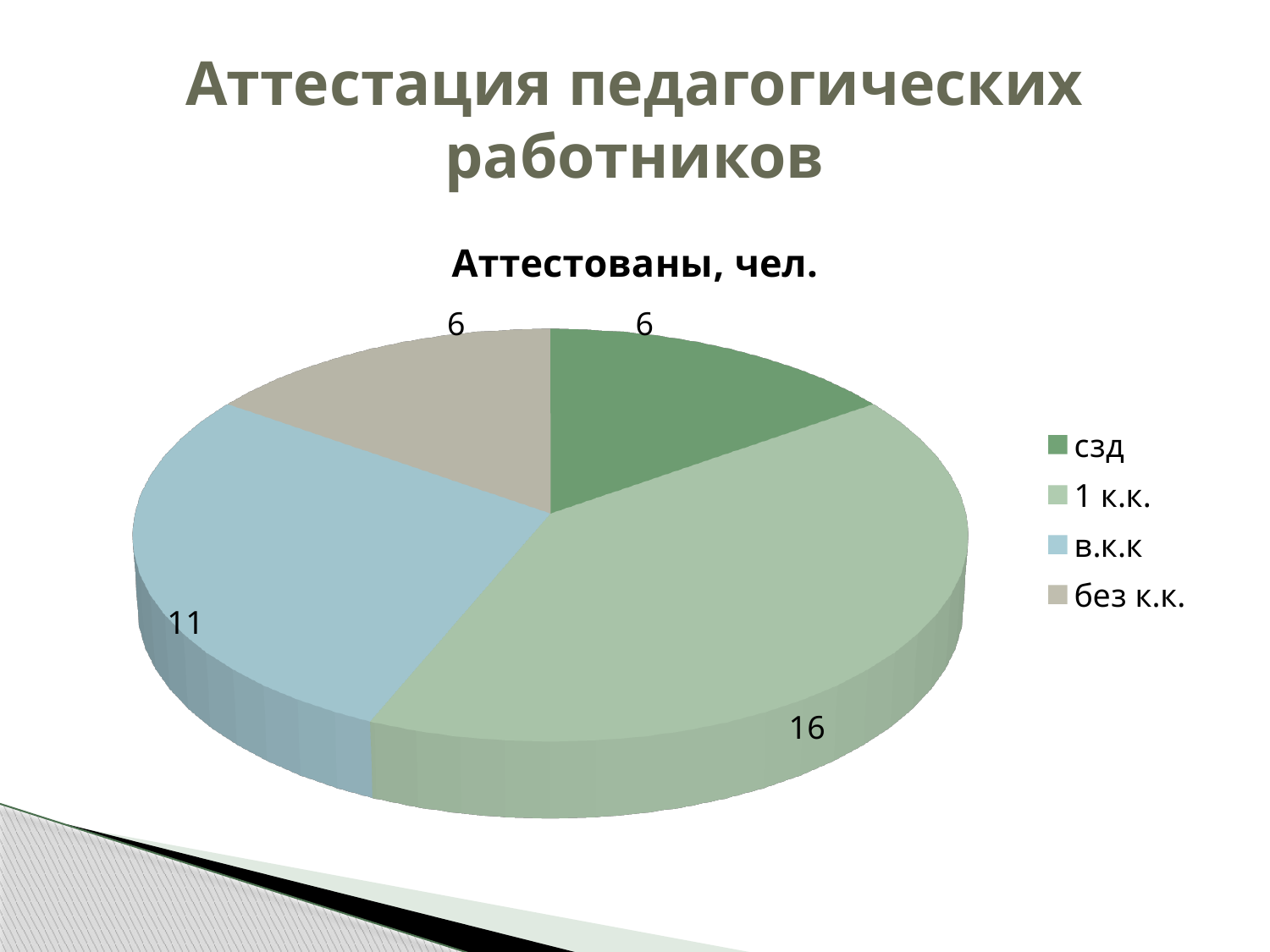
What is the value for без к.к.? 6 What kind of chart is shown on the slide? pie chart What is the title of the chart? Аттестованы, чел. How many slices does the pie chart have? 4 How many categories does the legend list? 4 What is the value for в.к.к? 11 What is the value for сзд? 6 What is the value for 1 к.к.? 16 Which is larger, the value for в.к.к or the value for сзд? в.к.к What is the difference between the values for 1 к.к. and в.к.к? 5 Which category has the largest slice? 1 к.к. What is the total of all slices in the pie chart? 39